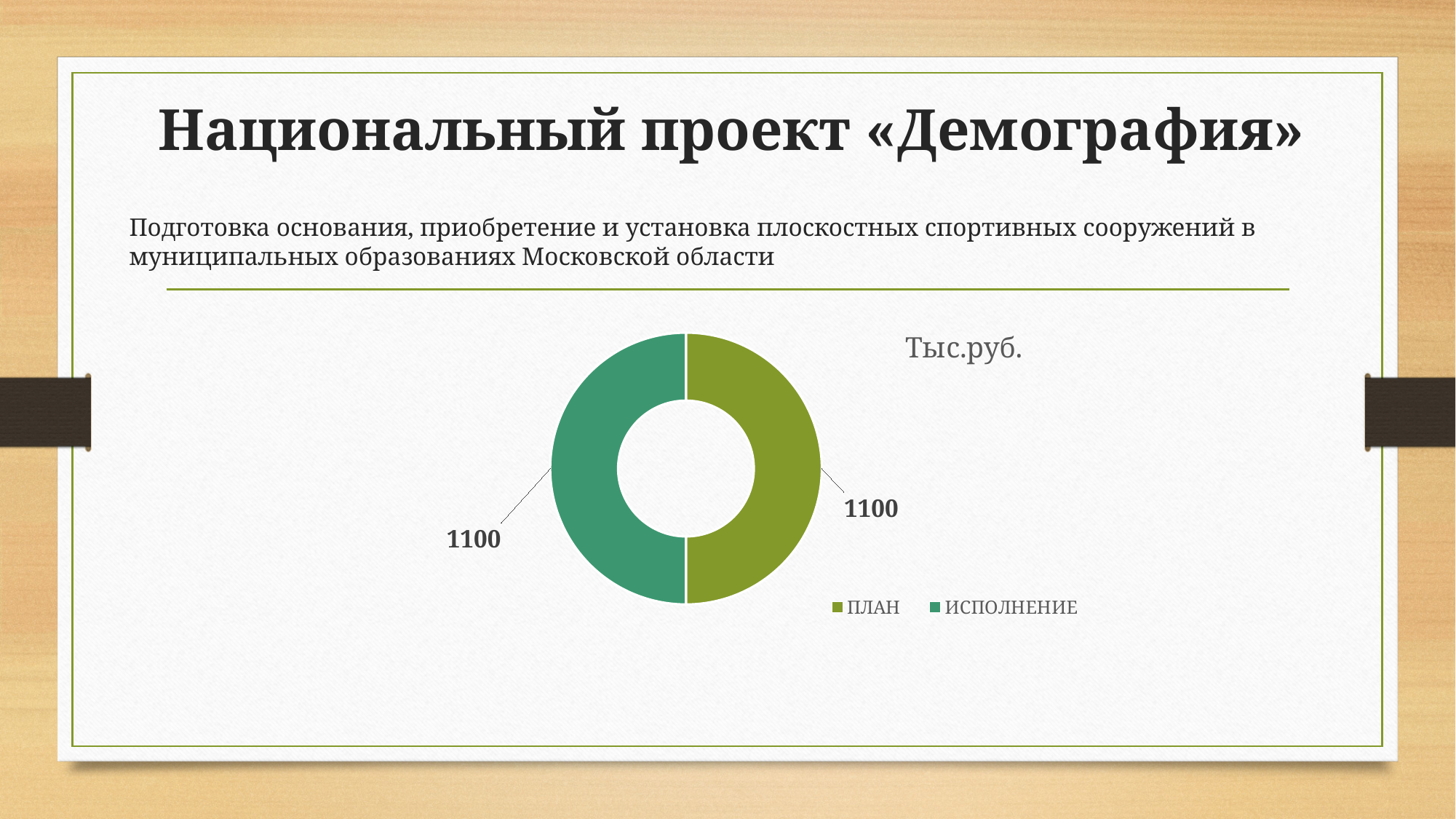
What is the value for ПЛАН in the doughnut chart? 1100 How many slices does the chart have? 2 What kind of chart is shown on the slide? Doughnut (pie) chart How many entries does the chart legend list? 2 What share of the chart does the ПЛАН slice represent? 50% What is the total of the two values shown in the chart? 2200 What is the difference between the ПЛАН and ИСПОЛНЕНИЕ values? 0 Which legend entry is shown in the darker teal-green colour? ИСПОЛНЕНИЕ What unit label is shown next to the chart? Тыс.руб. What share of the chart does the ИСПОЛНЕНИЕ slice represent? 50% What is the value for ИСПОЛНЕНИЕ in the doughnut chart? 1100